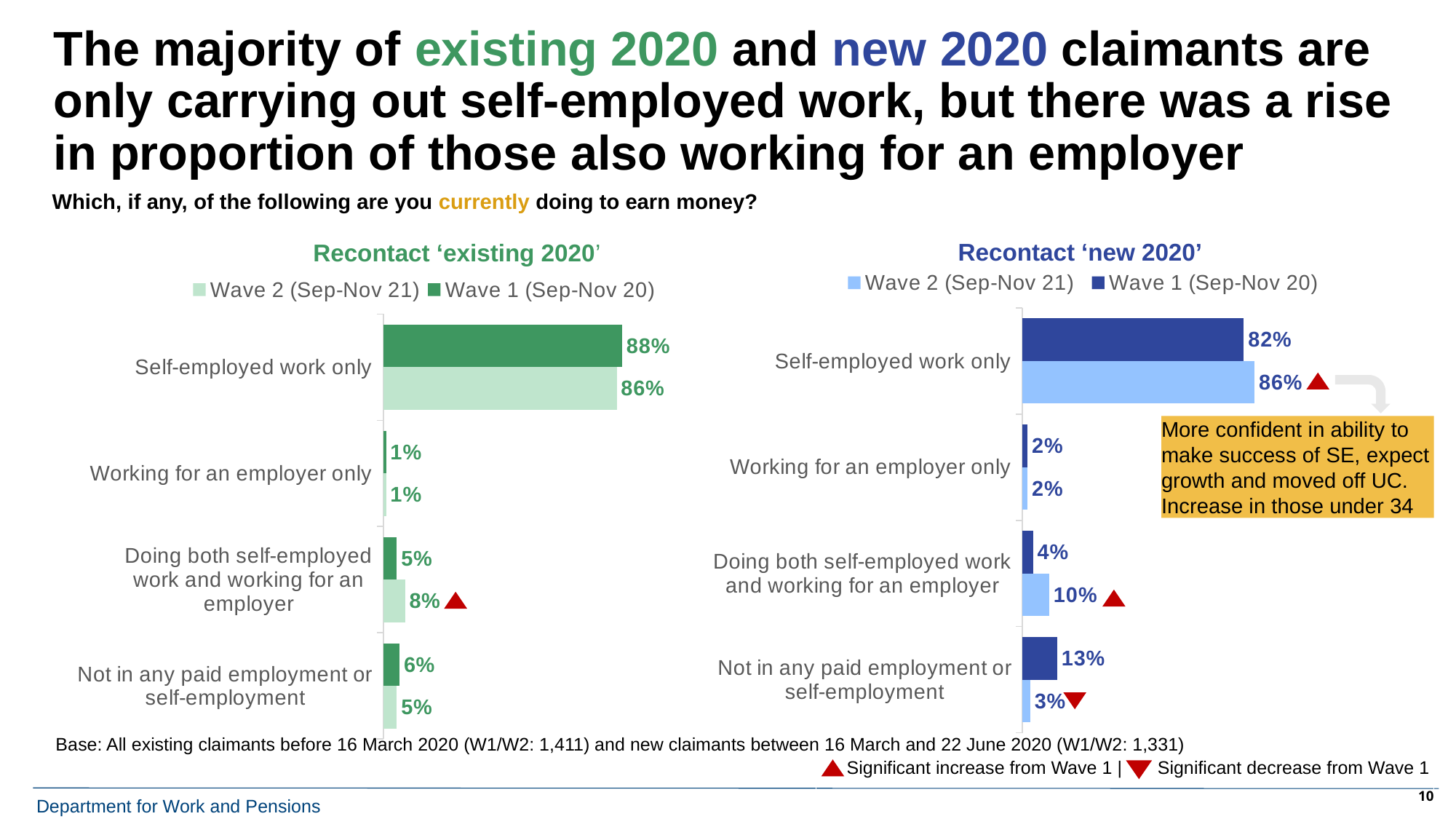
In the 'Recontact ‘existing 2020’' chart, which category has the lowest Wave 1 (Sep-Nov 20) value? Working for an employer only In the 'Recontact ‘new 2020’' chart, what is the difference between the Wave 1 and Wave 2 values for 'Not in any paid employment or self-employment'? 10% How many series does the legend of the 'Recontact ‘new 2020’' chart list? 2 In the 'Recontact ‘existing 2020’' chart, what is the Wave 2 (Sep-Nov 21) value for 'Doing both self-employed work and working for an employer'? 8% In the 'Recontact ‘new 2020’' chart, which category has the highest Wave 2 (Sep-Nov 21) value? Self-employed work only What type of chart is the 'Recontact ‘existing 2020’' chart? Bar chart How many categories are shown in the 'Recontact ‘existing 2020’' chart? 4 In the 'Recontact ‘existing 2020’' chart, what is the Wave 1 (Sep-Nov 20) value for 'Self-employed work only'? 88% In the 'Recontact ‘new 2020’' chart, what is the Wave 1 (Sep-Nov 20) value for 'Not in any paid employment or self-employment'? 13% In the 'Recontact ‘new 2020’' chart, what is the Wave 2 (Sep-Nov 21) value for 'Self-employed work only'? 86% In the 'Recontact ‘new 2020’' chart, which is larger for 'Doing both self-employed work and working for an employer': the Wave 1 value or the Wave 2 value? Wave 2 (Sep-Nov 21) In the 'Recontact ‘existing 2020’' chart, what is the difference between the Wave 1 and Wave 2 values for 'Self-employed work only'? 2%